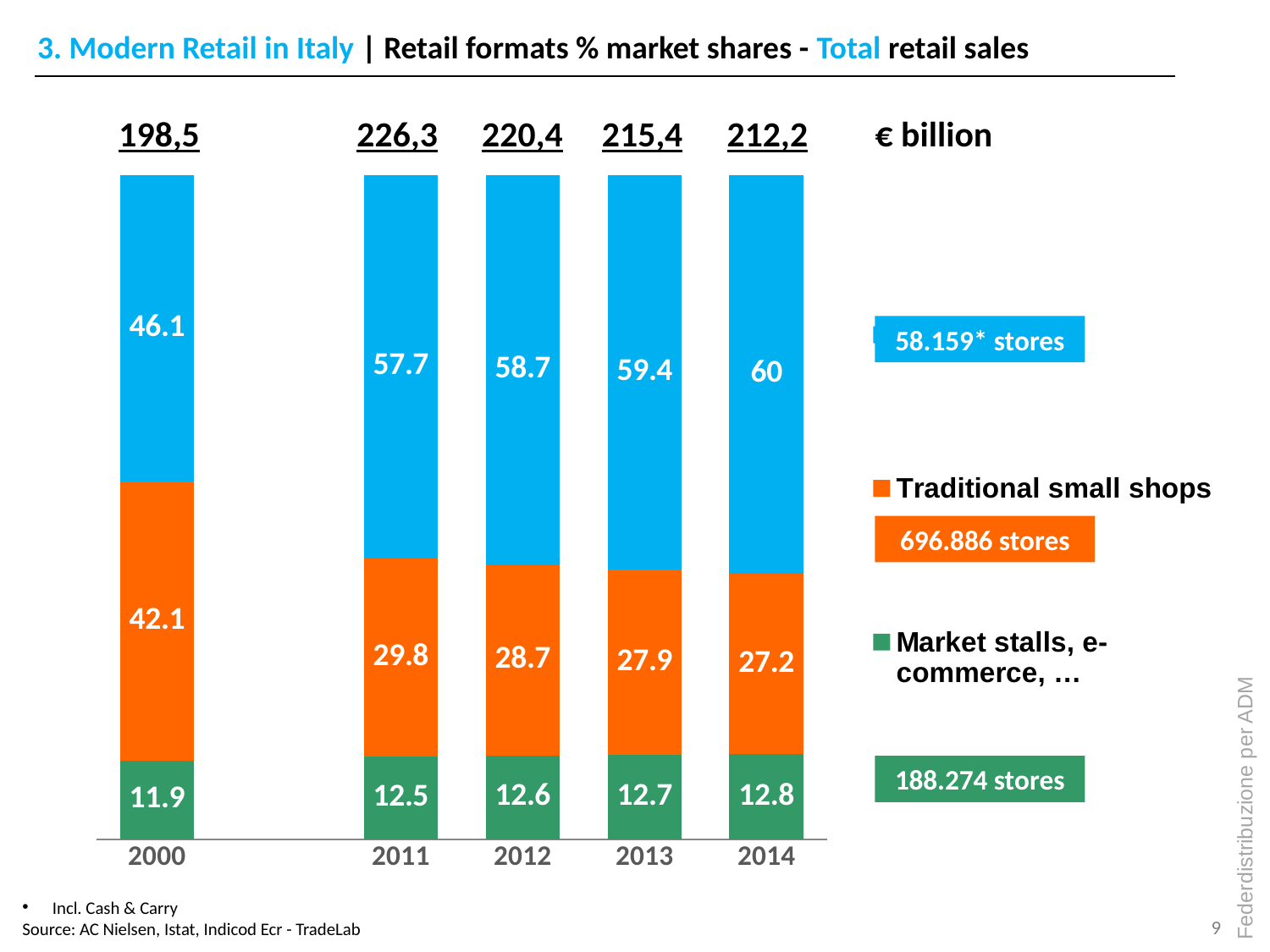
How many stores are shown for Traditional small shops? 696.886 stores How many years are shown on the x axis? 5 What total in € billion is shown above the 2011 bar? 226,3 What is the difference between the Traditional small shops values in 2000 and 2014? 14.9 What type of chart is shown on the slide? Stacked bar chart What is the value for Traditional small shops in 2000? 42.1 What is the value for Market stalls, e-commerce, … in 2014? 12.8 In which year is the Market stalls, e-commerce, … value lowest? 2000 Which is larger in 2013: the blue (top) segment or the Traditional small shops segment? The blue (top) segment What is the value of the blue (top) segment in 2012? 58.7 In which year is the Traditional small shops value highest? 2000 Does the Traditional small shops value rise or fall from 2011 to 2014? Fall